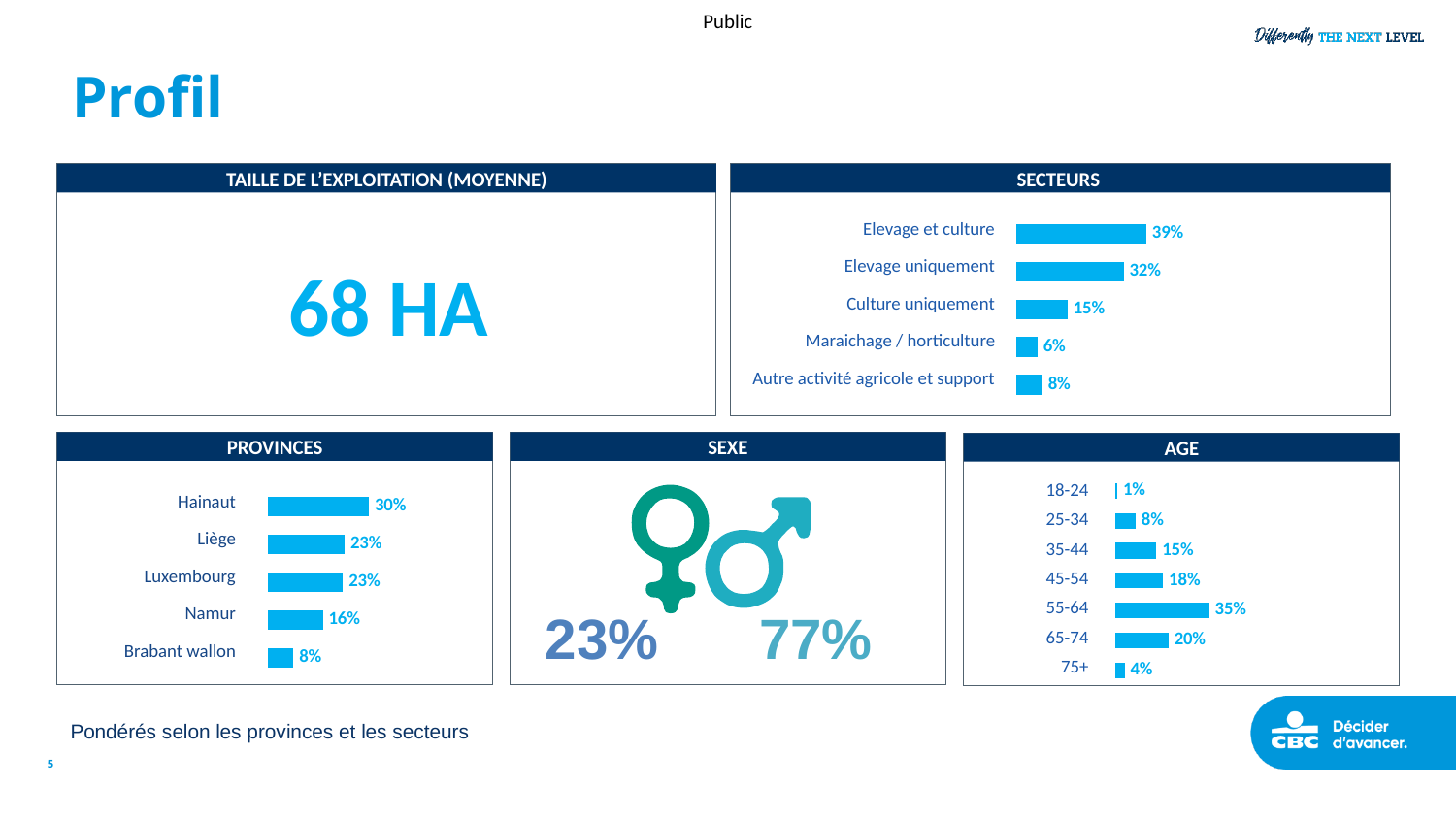
In the AGE chart, what is the difference between the 65-74 and 75+ groups? 16% In the PROVINCES chart, which is larger, Hainaut or Brabant wallon? Hainaut In the SECTEURS chart, what is the value for Elevage et culture? 39% In the SECTEURS chart, what is the difference between Elevage et culture and Elevage uniquement? 7% How many categories are shown in the SECTEURS chart? 5 What kind of chart is the PROVINCES chart? Bar chart In the PROVINCES chart, which province has the highest value? Hainaut In the PROVINCES chart, what is the value for Namur? 16% In the AGE chart, which age group has the lowest value? 18-24 In the SECTEURS chart, which category has the lowest value? Maraichage / horticulture How many age groups are shown in the AGE chart? 7 In the AGE chart, what is the value for the 55-64 group? 35%